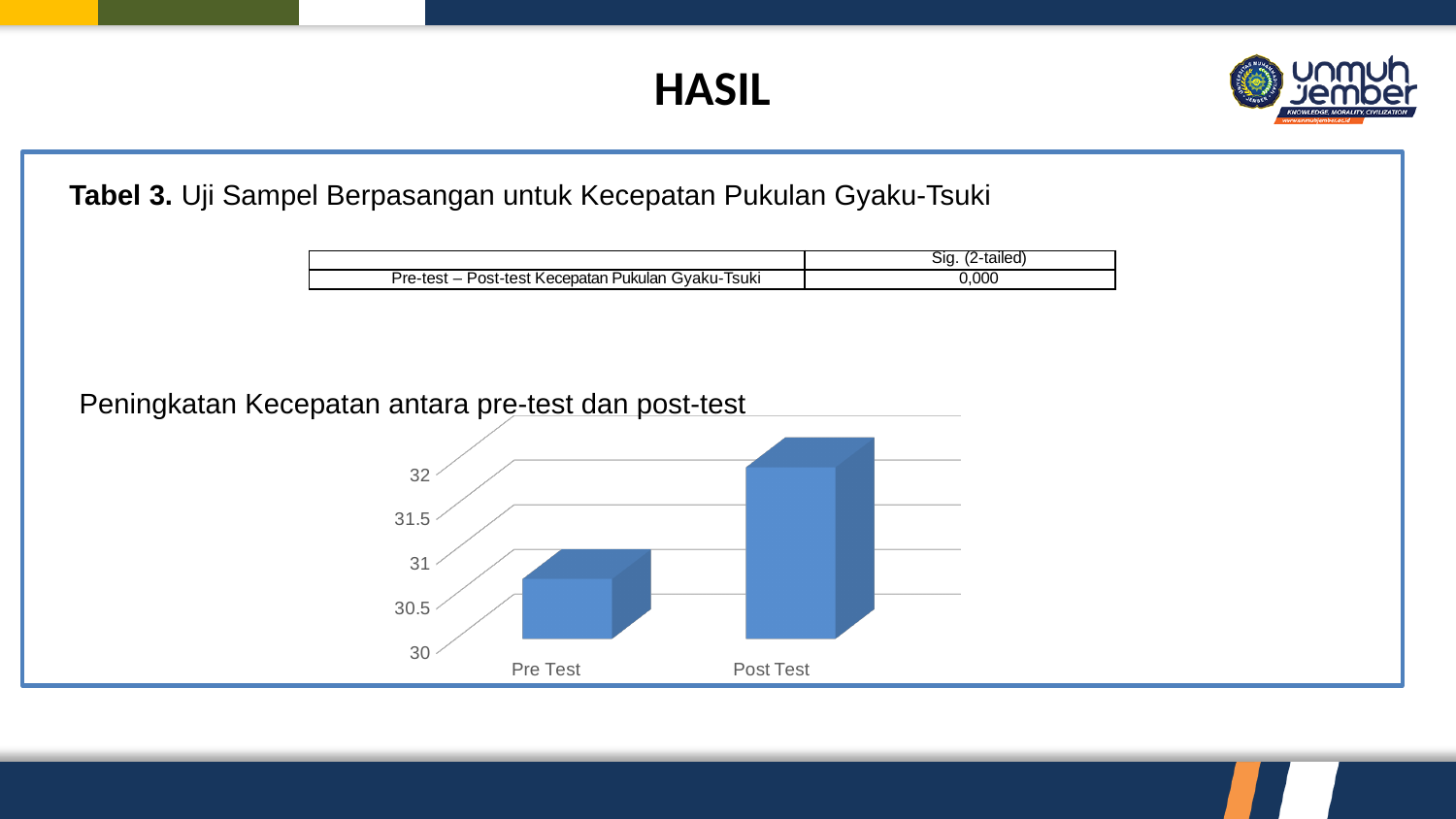
Which category has the lowest value in the chart? Pre Test Which category has the highest value in the chart? Post Test Do the values rise or fall from Pre Test to Post Test? rise What is the lowest value shown on the vertical axis of the chart? 30 What is the title of the chart on the slide? Peningkatan Kecepatan antara pre-test dan post-test How many categories are plotted in the chart? 2 What kind of chart is shown on the slide? bar chart Is the value for Pre Test greater or less than 31.5? less Which is larger, the value for Pre Test or the value for Post Test? Post Test Is the value for Post Test greater or less than 31.5? greater Is the value for Pre Test greater or less than 30.5? greater